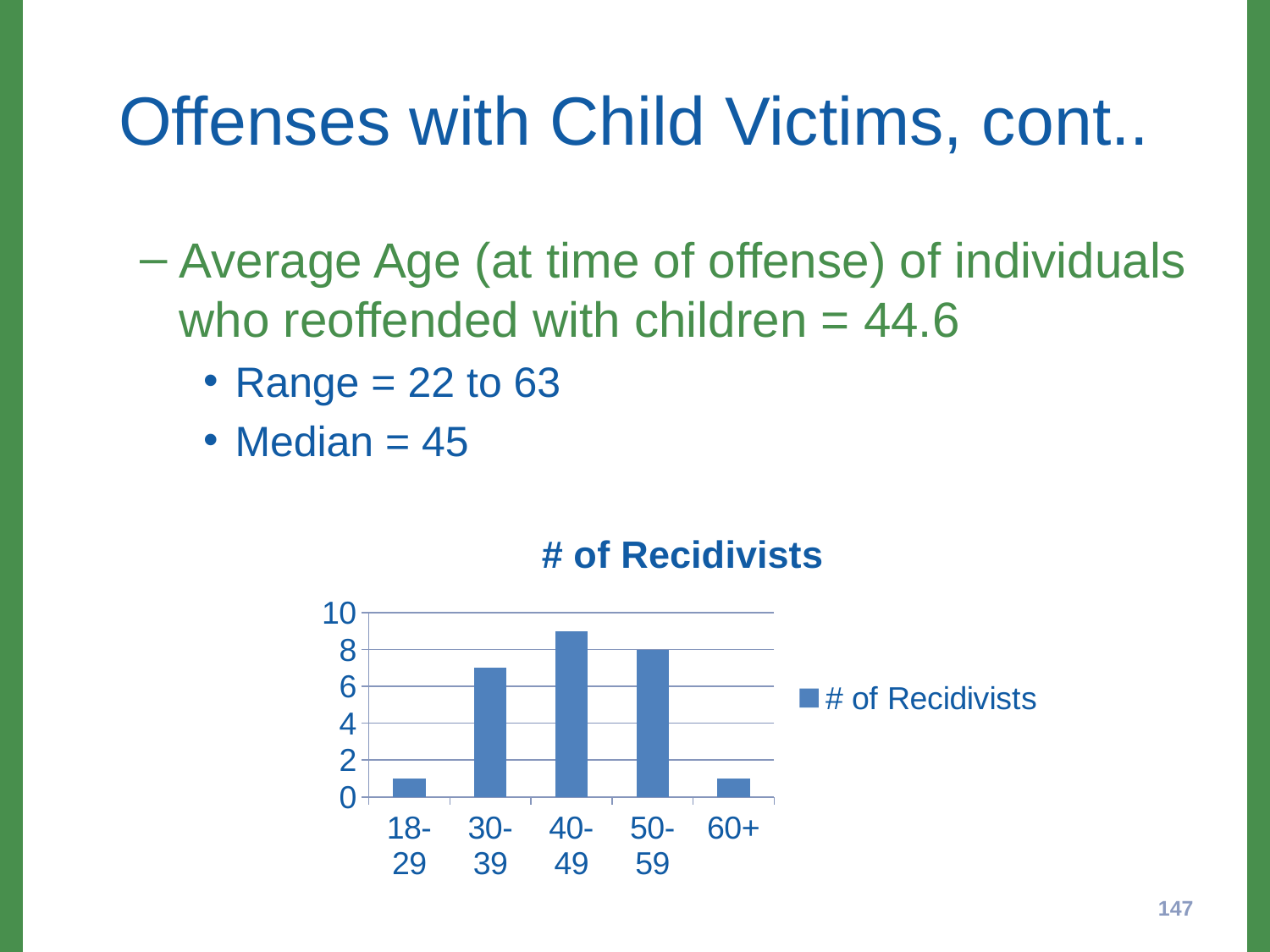
Is the value for the 60+ age category greater or less than 2? less What is the number of recidivists for the 50-59 age category? 8 How many age categories are shown on the x axis of the chart? 5 Do the values rise or fall from the 18-29 category to the 40-49 category? rise Is the value for the 40-49 age category greater or less than 8? greater Is the value for the 30-39 age category greater or less than 6? greater Which age category has the highest number of recidivists? 40-49 How many series does the chart's legend list? 1 What is the title of the chart? # of Recidivists What type of chart is shown on the slide? bar chart Which has more recidivists, the 30-39 category or the 40-49 category? 40-49